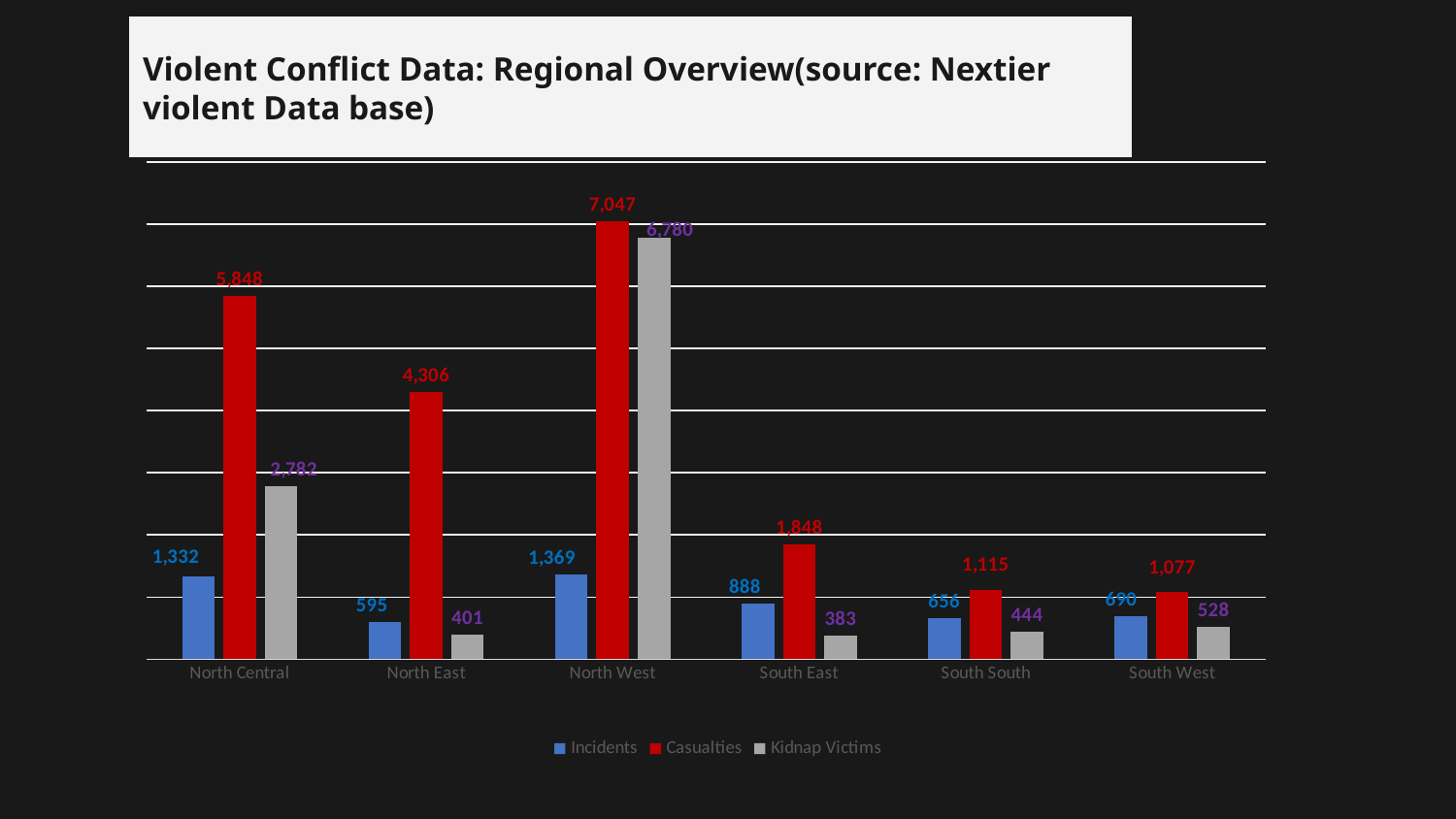
What is the number of Casualties for South East? 1,848 Which region has the lowest number of Casualties? South West How many regions are shown on the x axis? 6 How many series does the legend list? 3 Which region has more Incidents, North West or North Central? North West What kind of chart is shown on the slide? Bar chart Which region has the highest number of Casualties? North West What is the number of Casualties for North West? 7,047 What colour represents the Casualties series in the legend? Red What is the difference in Casualties between North Central and North East? 1,542 What is the number of Incidents for North Central? 1,332 What is the number of Kidnap Victims for North East? 401